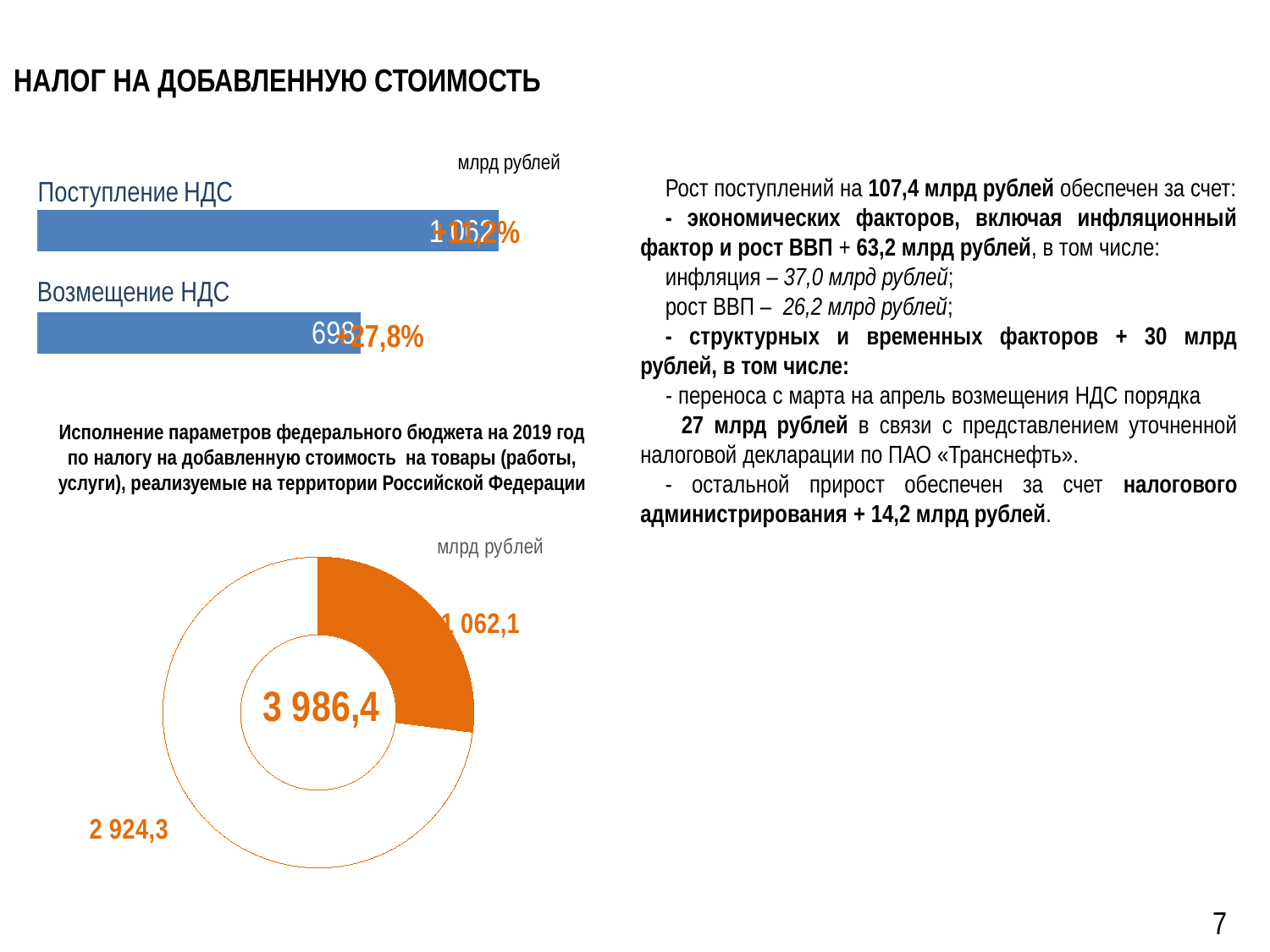
What type of chart is the lower chart on the left of the slide showing 3 986,4 in the centre? doughnut chart In the lower doughnut chart, what value is labelled on the orange slice? 1 062,1 In the lower doughnut chart, what value is printed in the centre? 3 986,4 In the upper bar chart, which category has the longer bar, Поступление НДС or Возмещение НДС? Поступление НДС What type of chart is the upper chart on the left of the slide (Поступление НДС / Возмещение НДС)? bar chart In the upper bar chart, what unit is stated above the bars? млрд рублей In the lower doughnut chart, how many slices are there? 2 In the lower doughnut chart, what value is labelled on the white (unfilled) slice? 2 924,3 In the upper bar chart, how many categories are shown? 2 In the lower doughnut chart, what is the difference between the slice labelled 2 924,3 and the slice labelled 1 062,1? 1 862,2 In the lower doughnut chart, what unit is stated above the chart? млрд рублей In the lower doughnut chart, which slice is larger, the one labelled 1 062,1 or the one labelled 2 924,3? 2 924,3